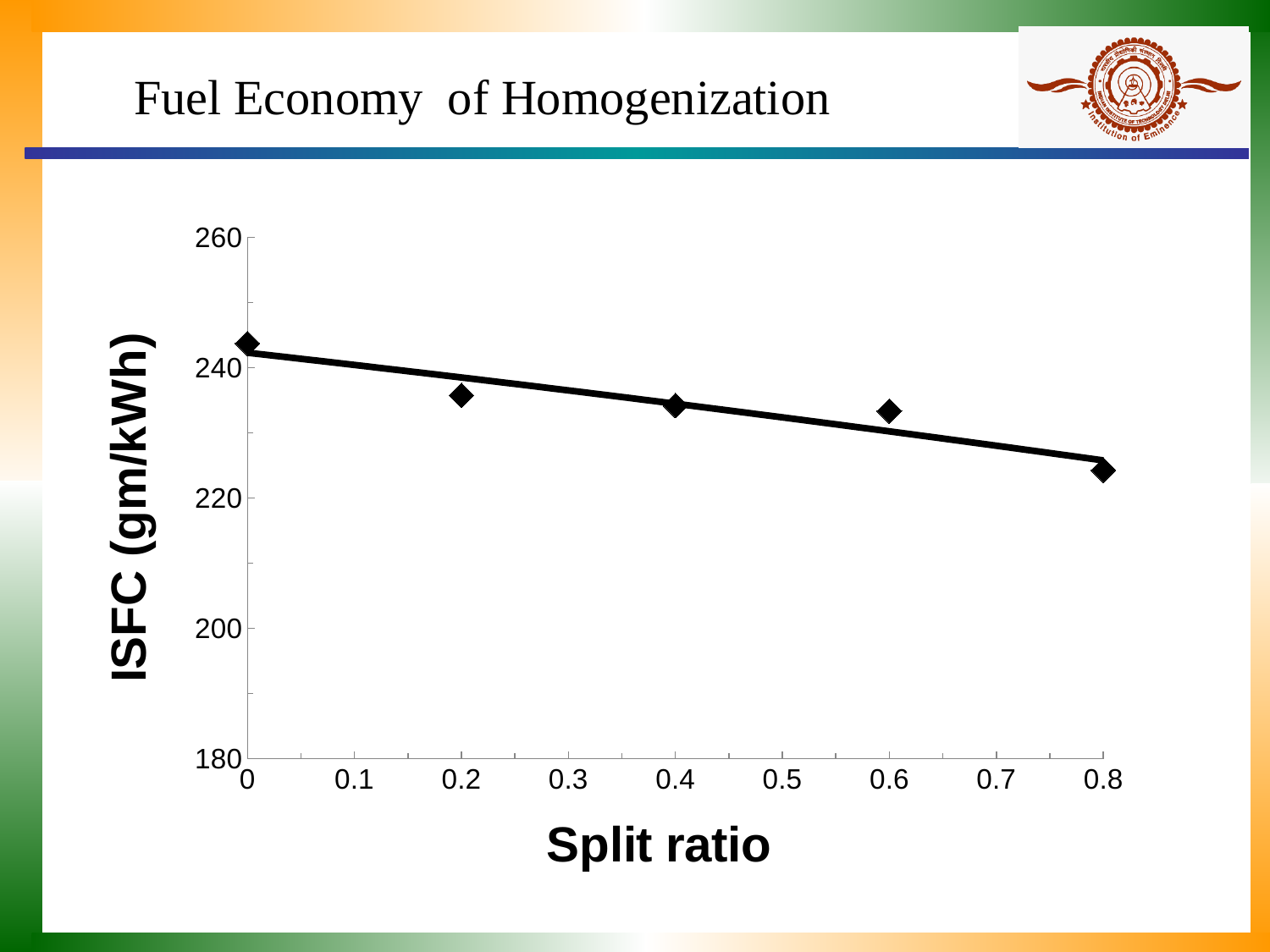
Is the ISFC value at split ratio 0.4 greater or less than 240? less At which split ratio is the ISFC lowest? 0.8 How many data points are plotted on the chart? 5 Is the ISFC value at split ratio 0 greater or less than 240? greater What kind of chart is shown on the slide? Scatter plot with a trend line Is the ISFC value at split ratio 0.6 greater or less than 220? greater What is the label on the y axis of the chart? ISFC (gm/kWh) Which has the larger ISFC value: split ratio 0.2 or split ratio 0.8? 0.2 At which split ratio is the ISFC highest? 0 Do the ISFC values rise or fall as the split ratio increases? Fall What is the label on the x axis of the chart? Split ratio